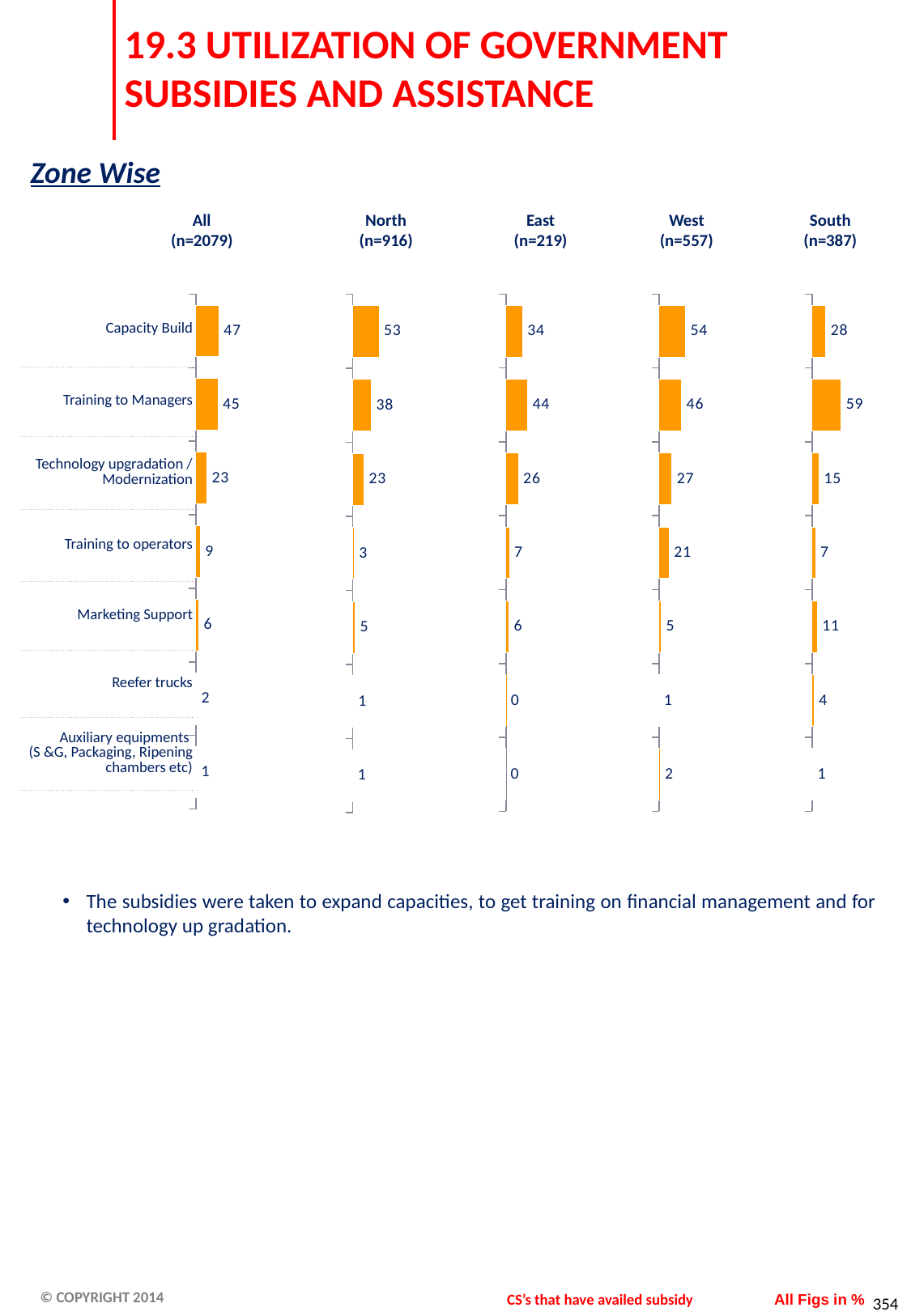
In the East (n=219) chart, what is the value for Reefer trucks? 0 In the All (n=2079) chart, what is the value for Capacity Build? 47 In the South (n=387) chart, which category has the highest value? Training to Managers What kind of chart is used for the North (n=916) data? Bar chart In the East (n=219) chart, what is the difference between Training to Managers and Capacity Build? 10 In the North (n=916) chart, which category has the highest value? Capacity Build In the West (n=557) chart, which is larger: Capacity Build or Training to Managers? Capacity Build In the North (n=916) chart, what is the difference between Capacity Build and Training to Managers? 15 How many zone charts are shown on the slide? 5 In the South (n=387) chart, what is the value for Marketing Support? 11 In the West (n=557) chart, what is the value for Training to operators? 21 How many categories are shown in the All (n=2079) chart? 7